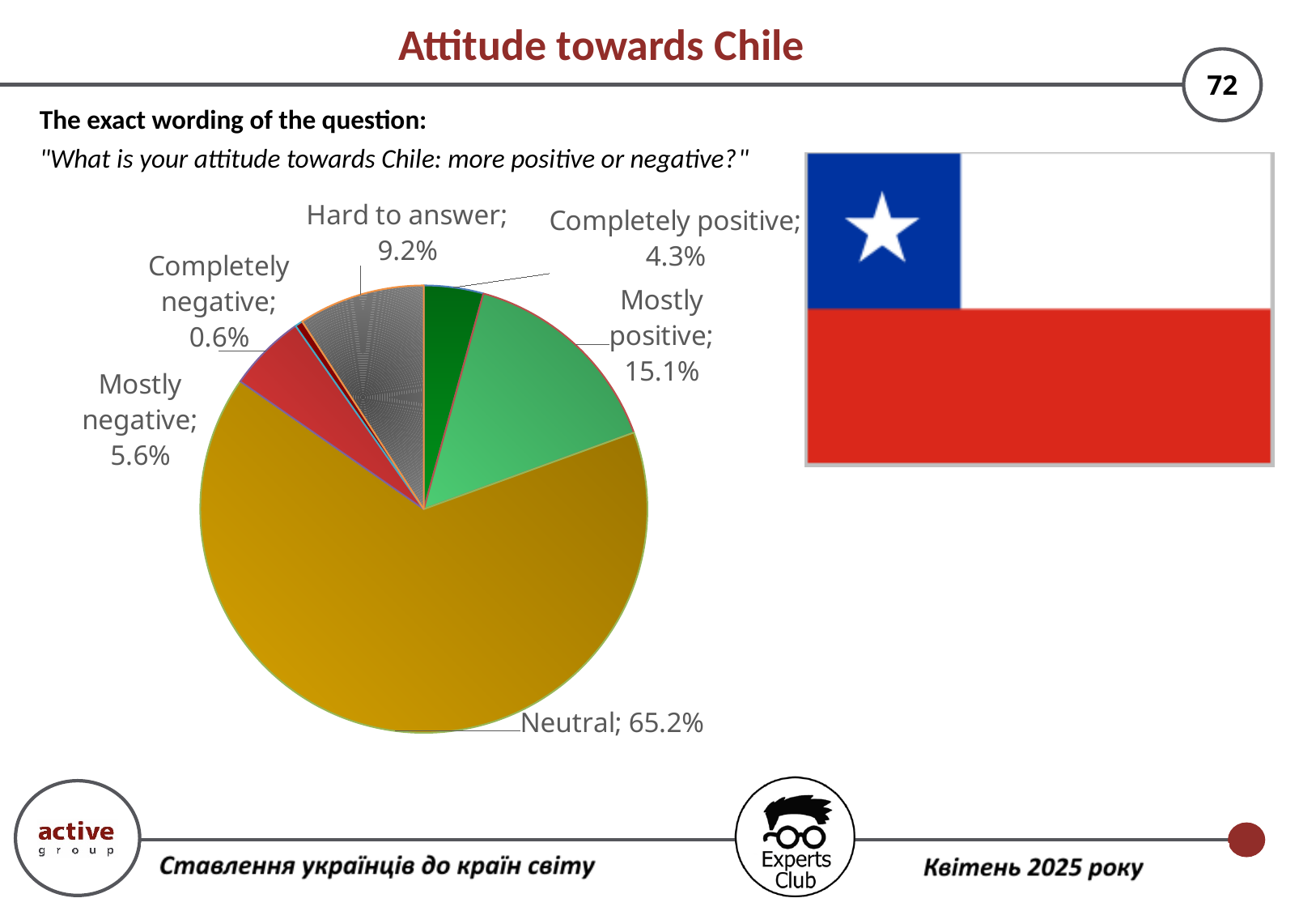
What is the combined share of "Completely positive" and "Mostly positive"? 19.4% What share of respondents answered "Hard to answer"? 9.2% What share of respondents answered "Completely negative"? 0.6% How many categories are shown in the pie chart? 6 What is the difference between the "Mostly positive" and "Mostly negative" shares? 9.5% What share of respondents answered "Mostly positive"? 15.1% What share of respondents answered "Neutral"? 65.2% What is the title of the slide containing the chart? Attitude towards Chile What kind of chart is shown on the slide? pie chart Which category has the smallest slice of the pie? Completely negative Which category has the largest slice of the pie? Neutral Which is larger: the "Hard to answer" share or the "Completely positive" share? Hard to answer